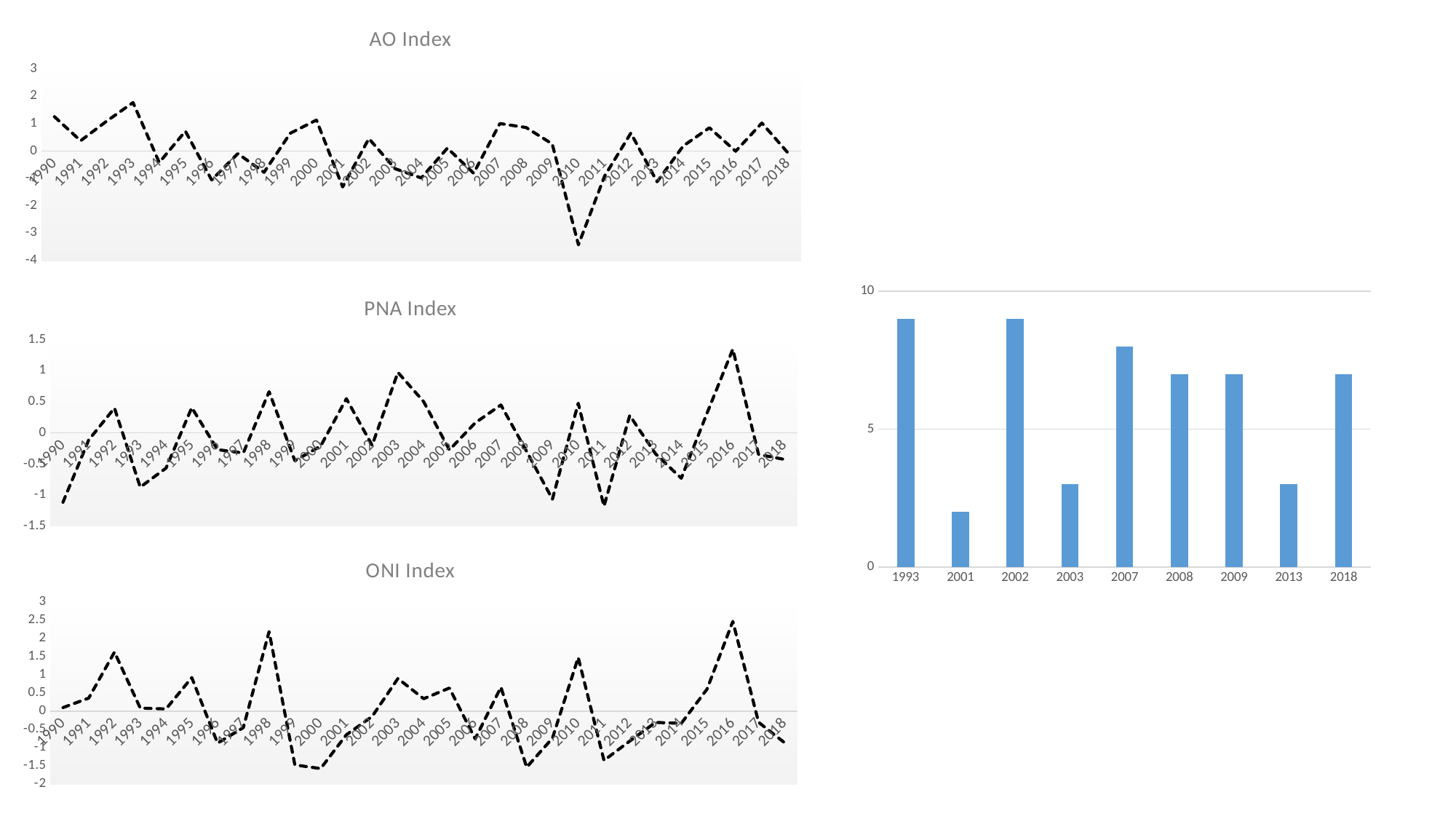
What kind of chart is the chart on the right side of the slide? bar chart In the AO Index chart, is the value for 2010 greater or less than -3? less In the AO Index chart, which year has the lowest value? 2010 What kind of chart is the AO Index chart? line chart In the bar chart on the right side of the slide, is the value for 1993 greater or less than 5? greater In the bar chart on the right side of the slide, which is larger, the value for 2007 or the value for 2013? 2007 What is the title of the bottom-left chart on the slide? ONI Index How many bars does the bar chart on the right side of the slide have? 9 In the bar chart on the right side of the slide, which year has the lowest bar? 2001 In the PNA Index chart, which year has the highest value? 2016 In the bar chart on the right side of the slide, is the value for 2003 greater or less than 5? less